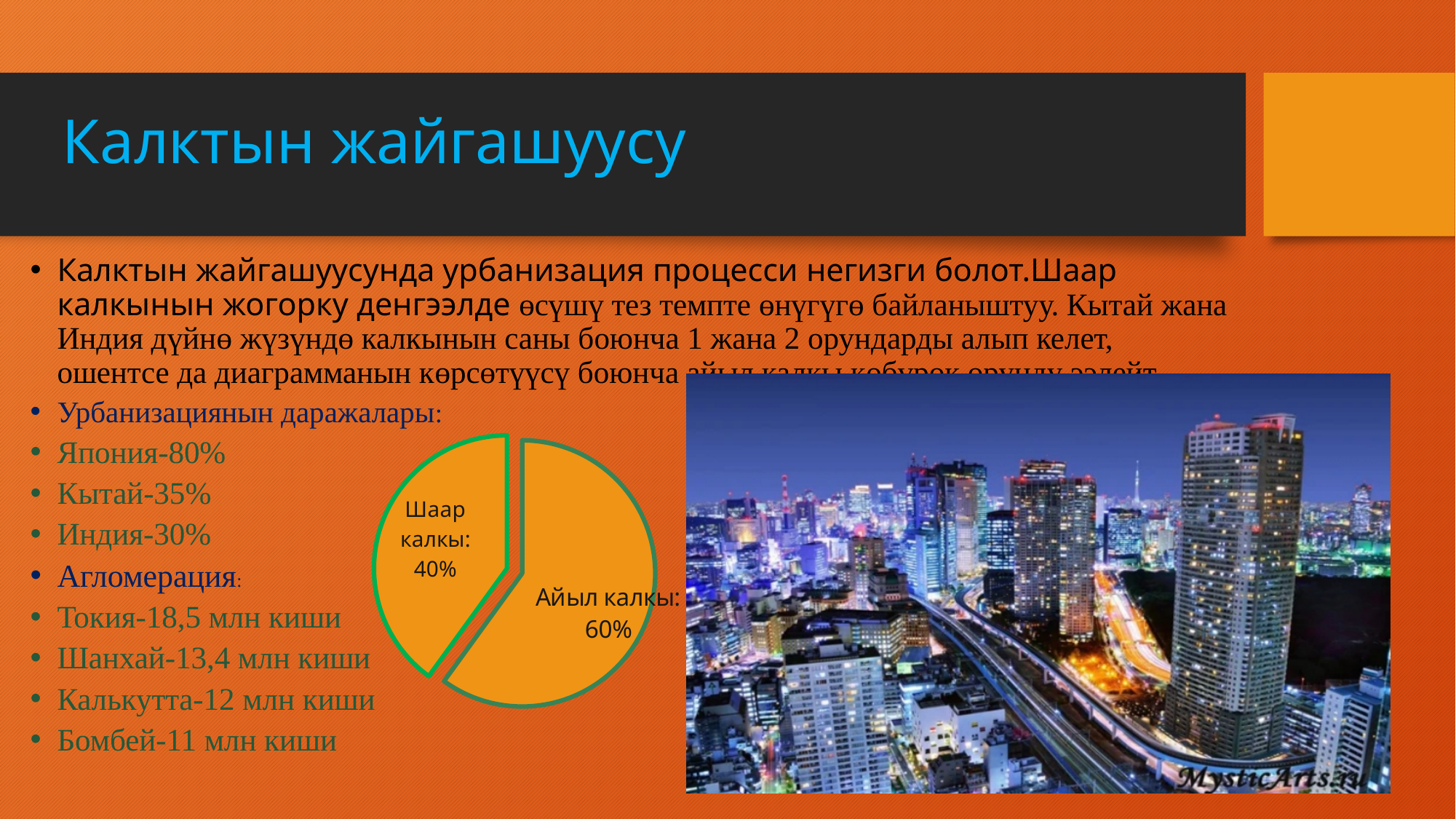
What share of the pie does "Айыл калкы" represent? 60% What is the total of the two slices shown in the pie chart? 100% How many slices does the pie chart have? 2 Is the value for "Айыл калкы" greater or less than 50%? greater Which slice of the pie chart is the largest? Айыл калкы Which slice of the pie chart is the smallest? Шаар калкы Which is larger in the pie chart, "Шаар калкы" or "Айыл калкы"? Айыл калкы What is the difference in percentage points between the "Айыл калкы" and "Шаар калкы" slices? 20% Is the value for "Шаар калкы" greater or less than 50%? less Which slice of the pie chart is pulled out (exploded) from the rest? Шаар калкы What share of the pie does "Шаар калкы" represent? 40% What kind of chart is shown on the slide? pie chart